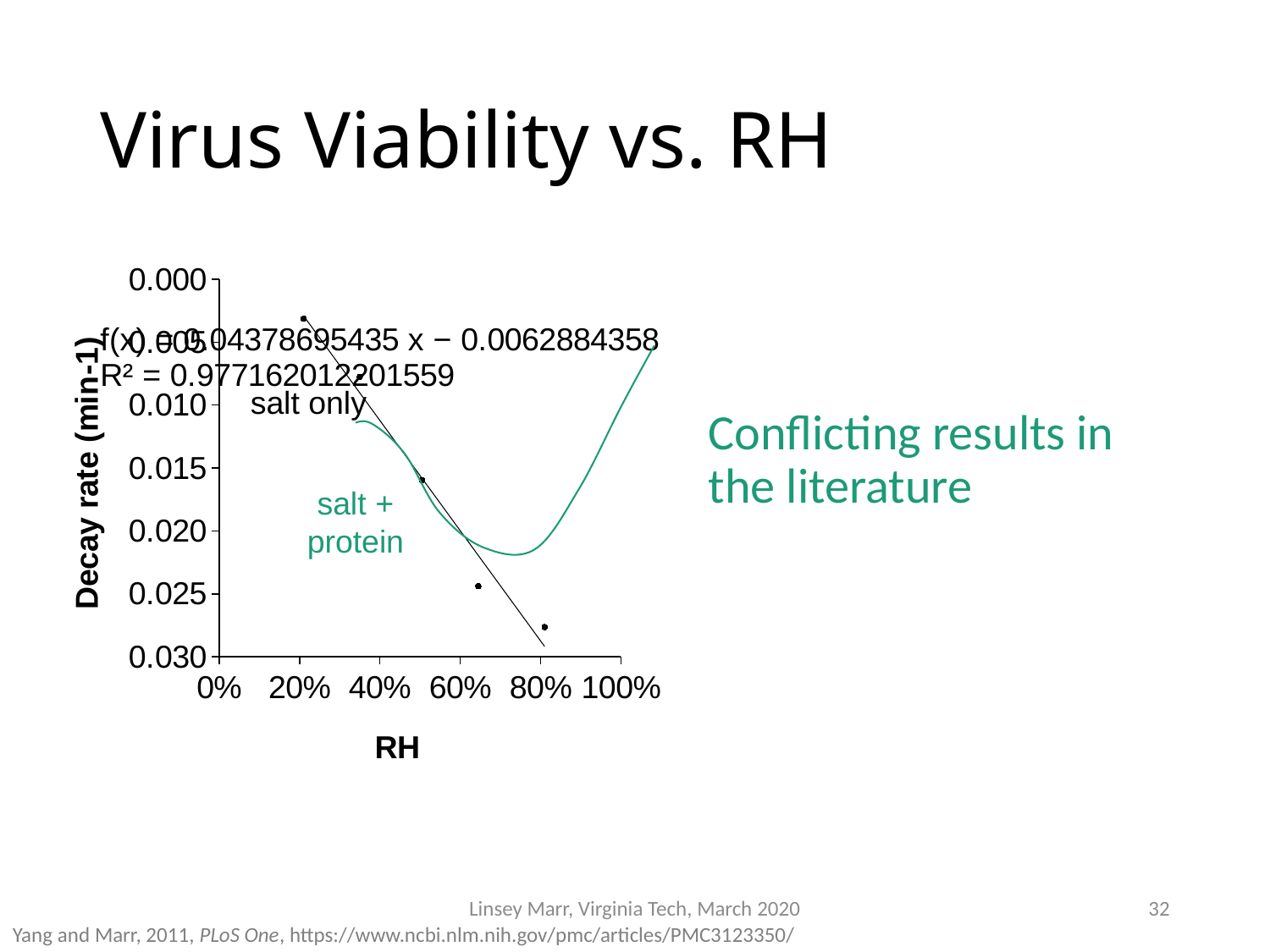
What is the R² value printed on the chart? 0.977162012201559 What is the label on the y axis of the chart? Decay rate (min-1) How many data points are plotted in the chart? 5 What is the trendline equation printed on the chart? f(x) = 0.04378695435 x − 0.0062884358 What label is given to the green curve on the chart? salt + protein Which point has a larger decay rate, the one at 20% RH or the one at 80% RH? 80% RH Does the decay rate increase or decrease as RH increases along the x axis? increase Is the decay rate for the point at 20% RH greater or less than 0.005? less What kind of chart is shown on the slide? scatter chart Is the decay rate for the point at 80% RH greater or less than 0.025? greater